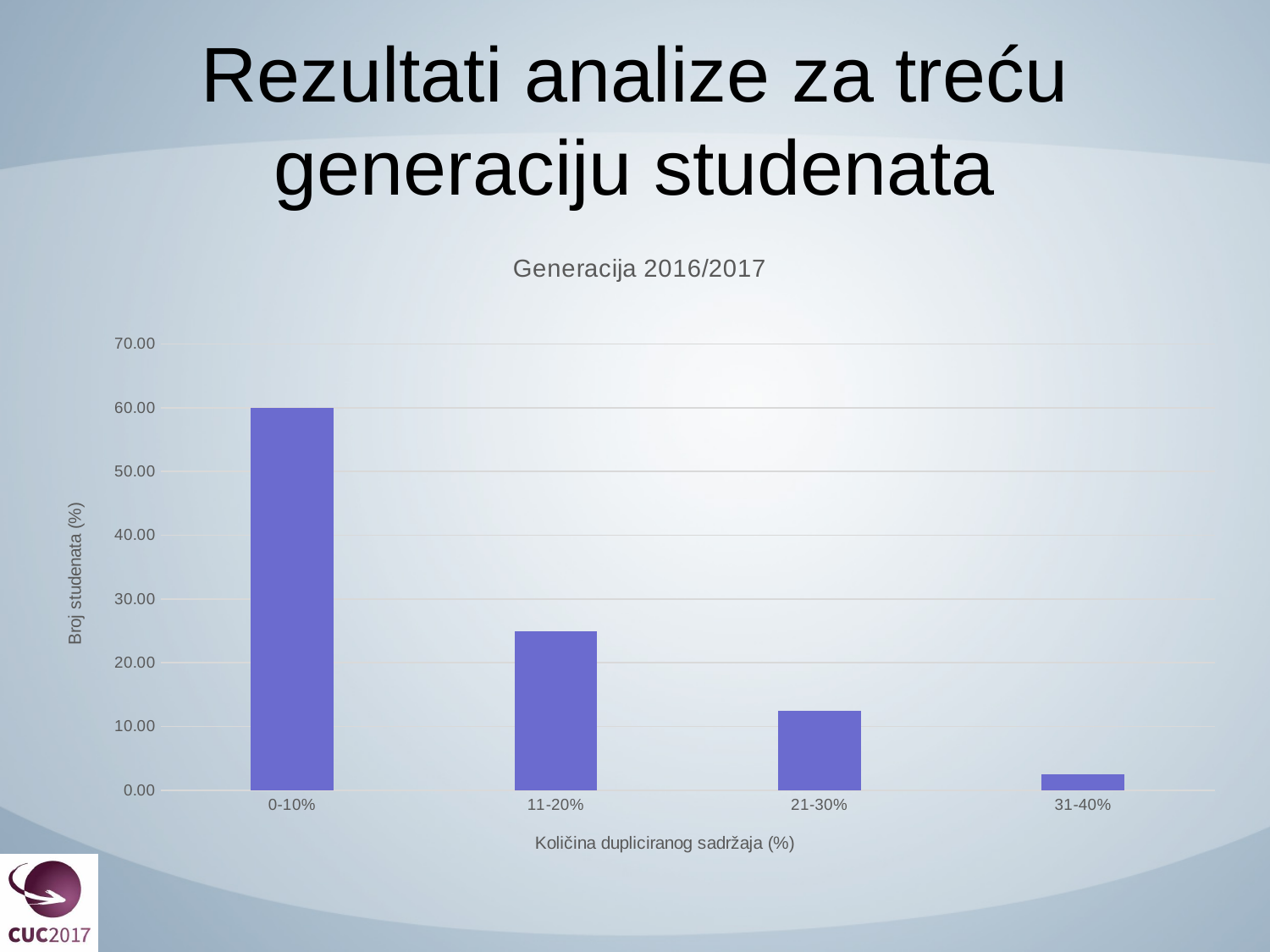
Do the values rise or fall from left to right along the x axis? fall Is the value for 31-40% greater or less than 10.00? less Which category has the lowest value? 31-40% What is the title of the chart? Generacija 2016/2017 Is the value for 11-20% greater or less than 20.00? greater Which category has the highest value? 0-10% What type of chart is shown on the slide? bar chart Is the value for 21-30% greater or less than 10.00? greater What is the value for the 0-10% category? 60.00 How many categories are shown on the x axis of the chart? 4 Which is larger, the value for 11-20% or the value for 21-30%? 11-20%